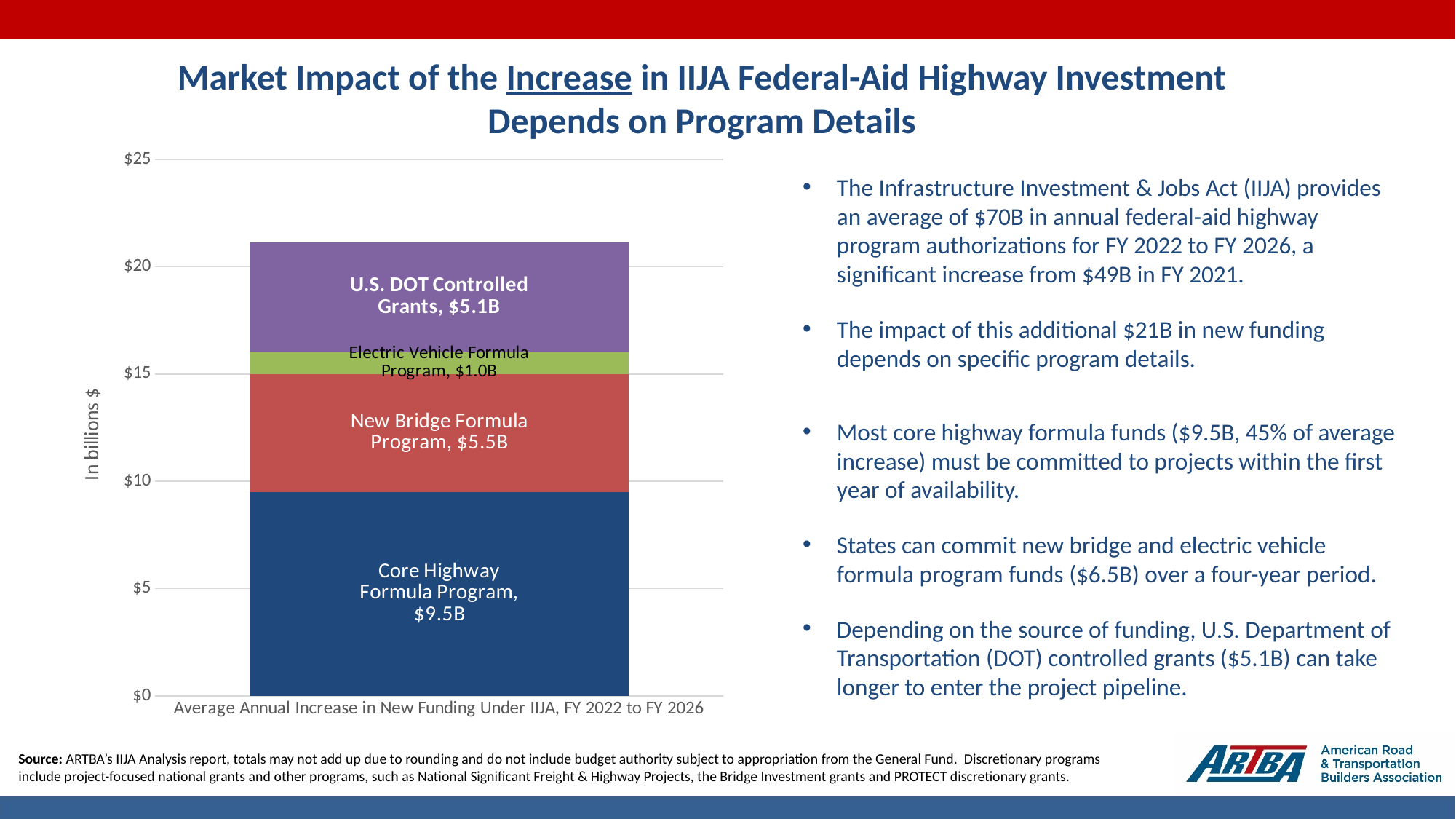
What type of chart is shown on the slide? Stacked bar chart What is the total of the stacked bar, summing the four labelled segments? $21.1B What is the value for the New Bridge Formula Program segment? $5.5B What is the label on the vertical axis of the chart? In billions $ What is the value for the Core Highway Formula Program segment? $9.5B How many segments make up the stacked bar? 4 What is the value for the U.S. DOT Controlled Grants segment? $5.1B Which segment of the stacked bar has the largest value? Core Highway Formula Program What is the difference between the Core Highway Formula Program and the New Bridge Formula Program values? $4.0B What is the value for the Electric Vehicle Formula Program segment? $1.0B Which is larger, the New Bridge Formula Program or the U.S. DOT Controlled Grants? New Bridge Formula Program Which segment of the stacked bar has the smallest value? Electric Vehicle Formula Program